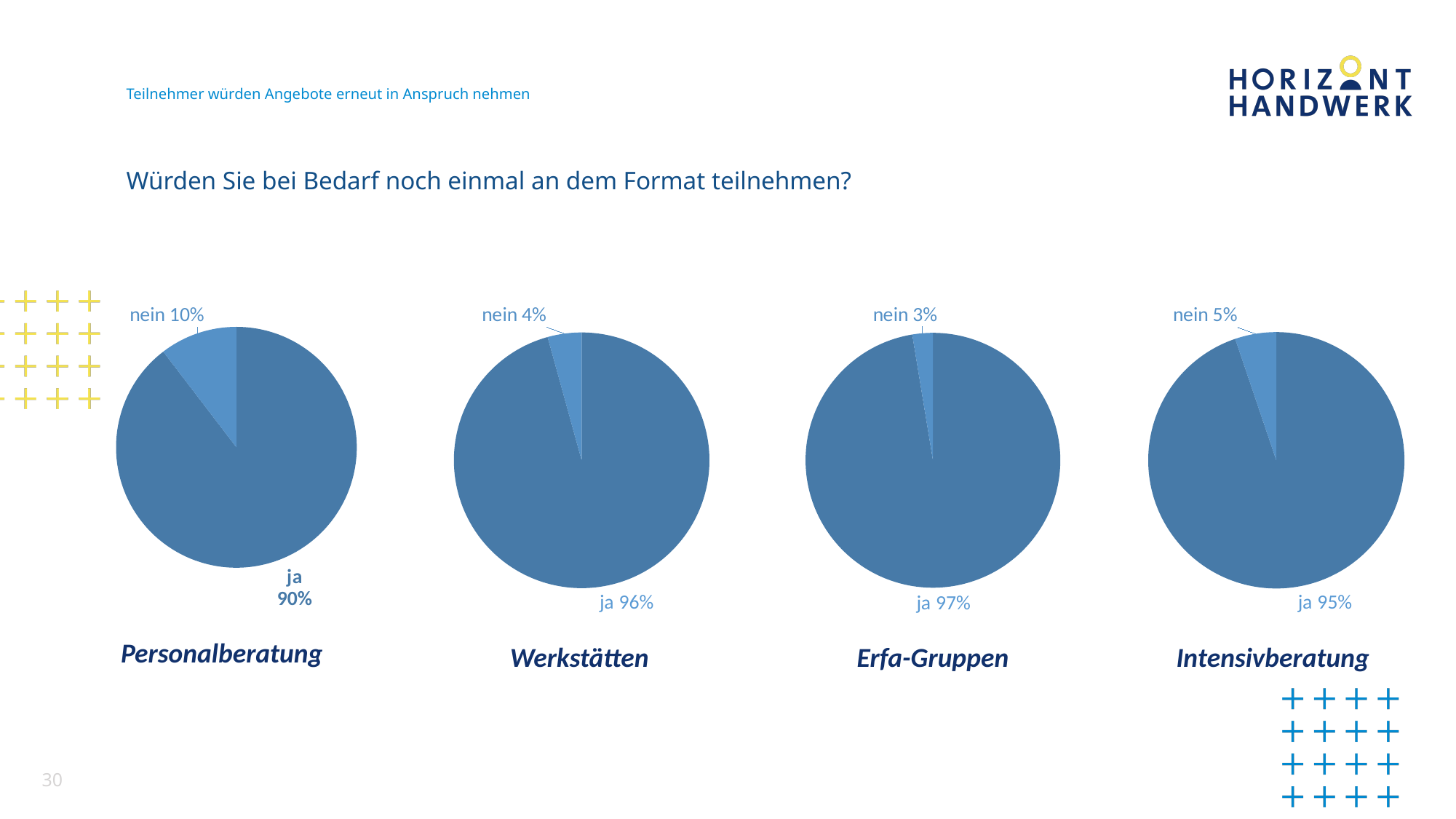
Across the four pie charts, which format has the highest "ja" share? Erfa-Gruppen In the Werkstätten pie chart, what share of respondents answered "nein"? 4% In the Intensivberatung pie chart, what share of respondents answered "nein"? 5% In the Personalberatung pie chart, what is the difference between the "ja" and "nein" shares? 80 percentage points How many slices does the Intensivberatung pie chart have? 2 What type of chart is used for the Werkstätten data? Pie chart Is the "nein" share larger in the Personalberatung chart or in the Werkstätten chart? Personalberatung What question do the pie charts on the slide answer? Würden Sie bei Bedarf noch einmal an dem Format teilnehmen? How many pie charts are shown on the slide? 4 In the Personalberatung pie chart, what share of respondents answered "ja"? 90% In the Erfa-Gruppen pie chart, what share of respondents answered "ja"? 97% Across the four pie charts, which format has the lowest "ja" share? Personalberatung